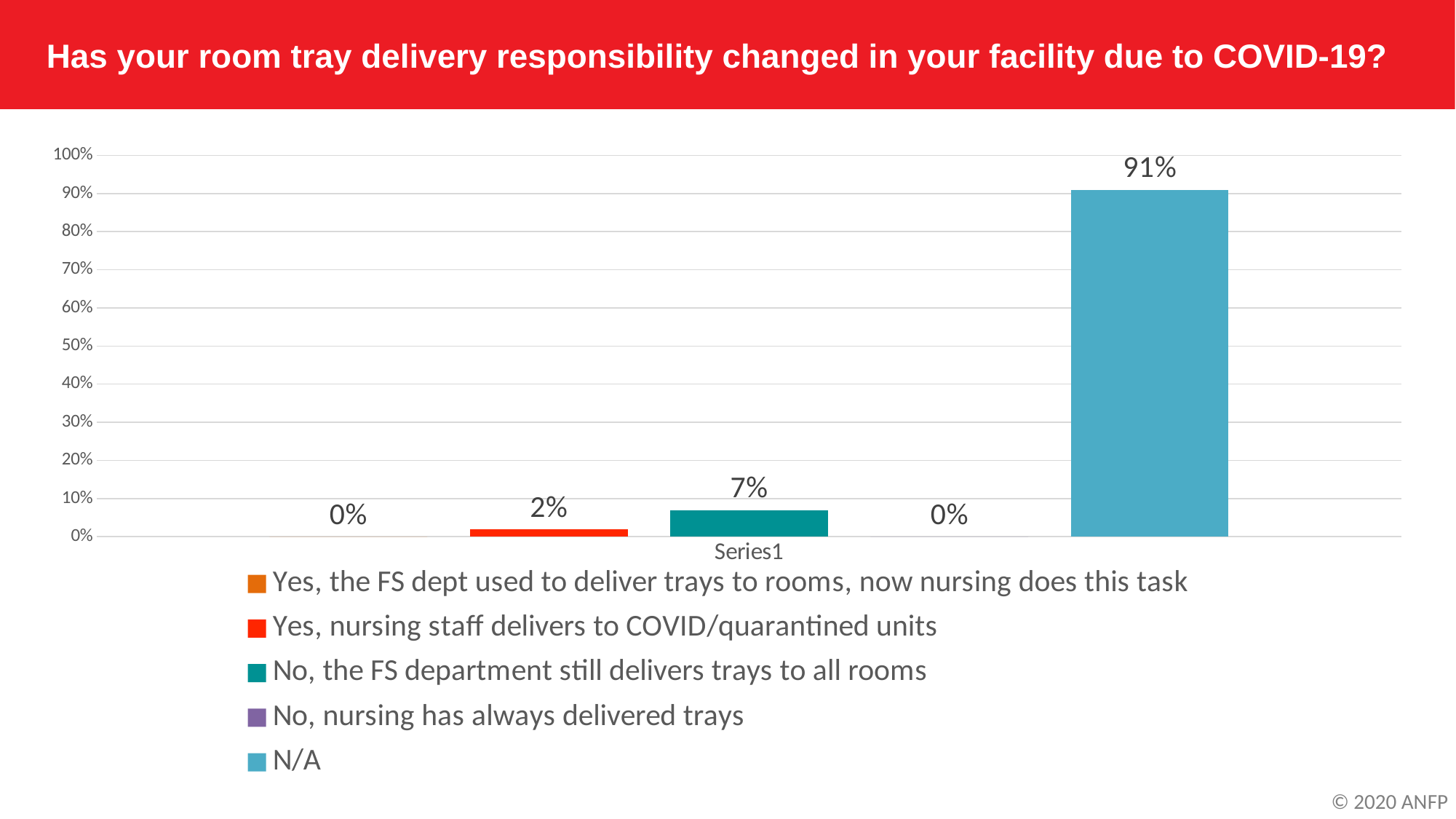
What is the value for "No, the FS department still delivers trays to all rooms"? 7% Is the value for N/A greater or less than 80%? greater What is the value for N/A? 91% What is the title of the chart? Has your room tray delivery responsibility changed in your facility due to COVID-19? Which is larger: "No, the FS department still delivers trays to all rooms" or "Yes, nursing staff delivers to COVID/quarantined units"? No, the FS department still delivers trays to all rooms What is the value for "No, nursing has always delivered trays"? 0% What is the value for "Yes, nursing staff delivers to COVID/quarantined units"? 2% What is the difference between the N/A value and the value for "No, the FS department still delivers trays to all rooms"? 84% What colour is the bar for N/A? light blue How many series does the legend list? 5 What kind of chart is shown on the slide? bar chart Which response has the highest value? N/A